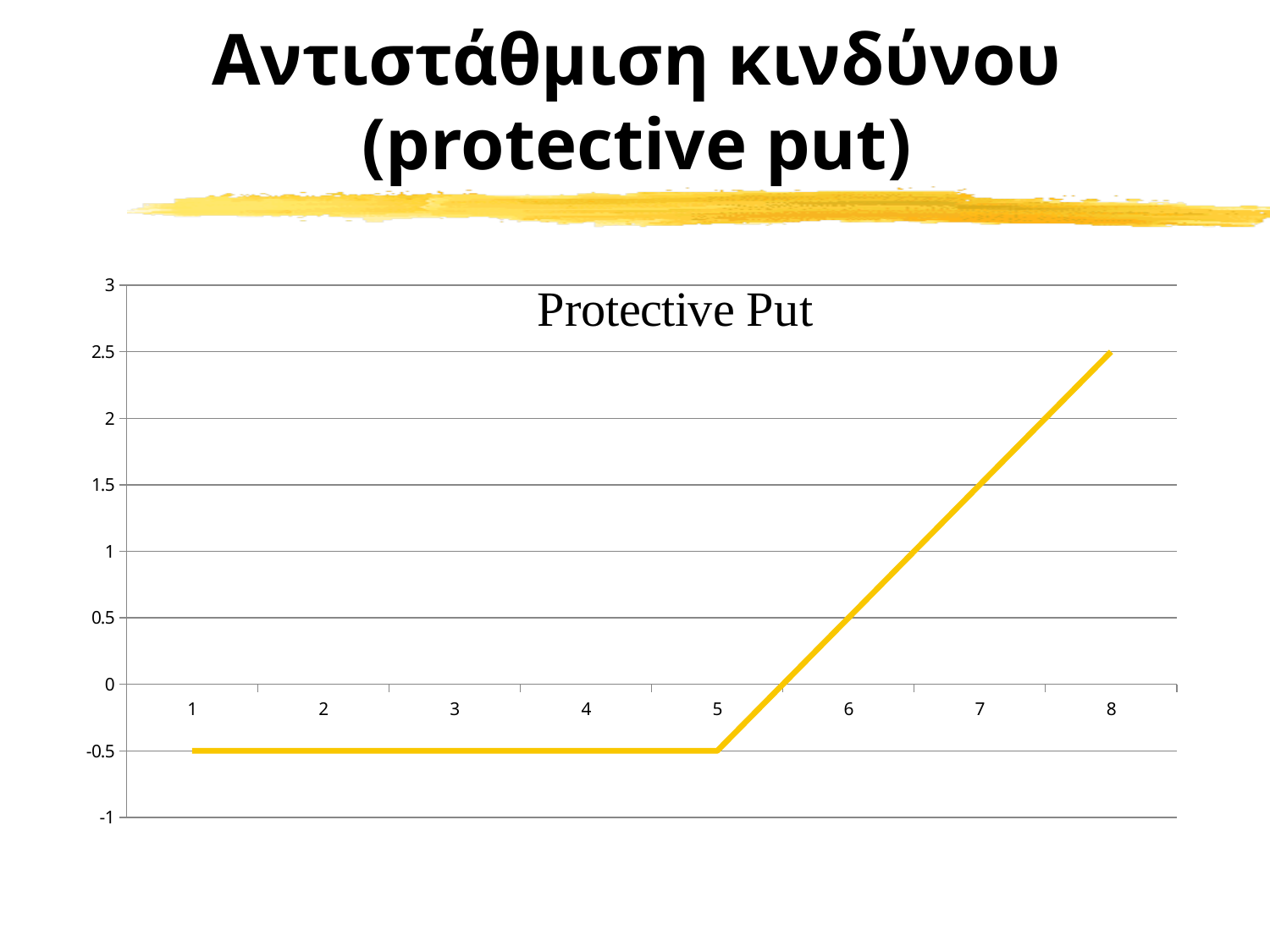
Does the line rise, fall or stay flat between x = 1 and x = 5? stays flat How many points are plotted along the x axis? 8 Is the value at x = 3 greater or less than 0? less What is the value of the line at x = 5? -0.5 What is the value of the line at x = 1? -0.5 At which x value does the line reach its highest point? 8 Which is larger, the value at x = 7 or the value at x = 4? x = 7 What kind of chart is shown on the slide? line chart What is the value of the line at x = 8? 2.5 What is the value of the line at x = 7? 1.5 What is the title of the chart? Protective Put Is the value at x = 6 greater or less than 0? greater